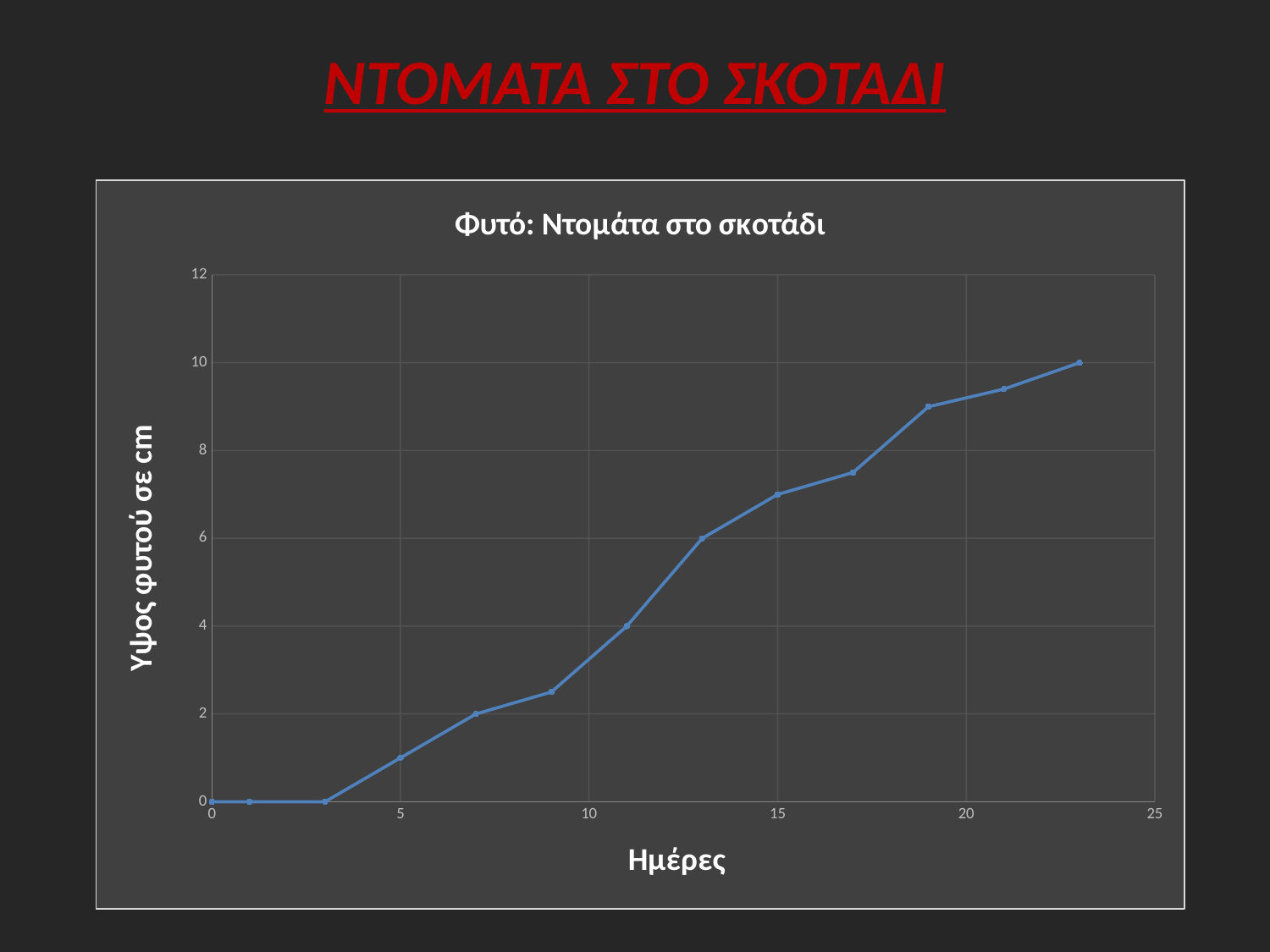
Is the plant height at day 15 greater or less than 8? less Is the plant height at day 5 greater or less than 2? less Is the plant height at day 15 greater or less than 6? greater What kind of chart is shown on the slide? line chart What is the title of the chart? Φυτό: Ντομάτα στο σκοτάδι Which is larger, the plant height at day 5 or at day 15? day 15 What is the label of the x axis? Ημέρες What is the highest plant height reached on the chart, in cm? 10 What is the plant height at day 0? 0 How many data points are plotted on the line? 13 Does the plant height rise or fall as the days increase? rise What is the maximum value shown on the y axis? 12